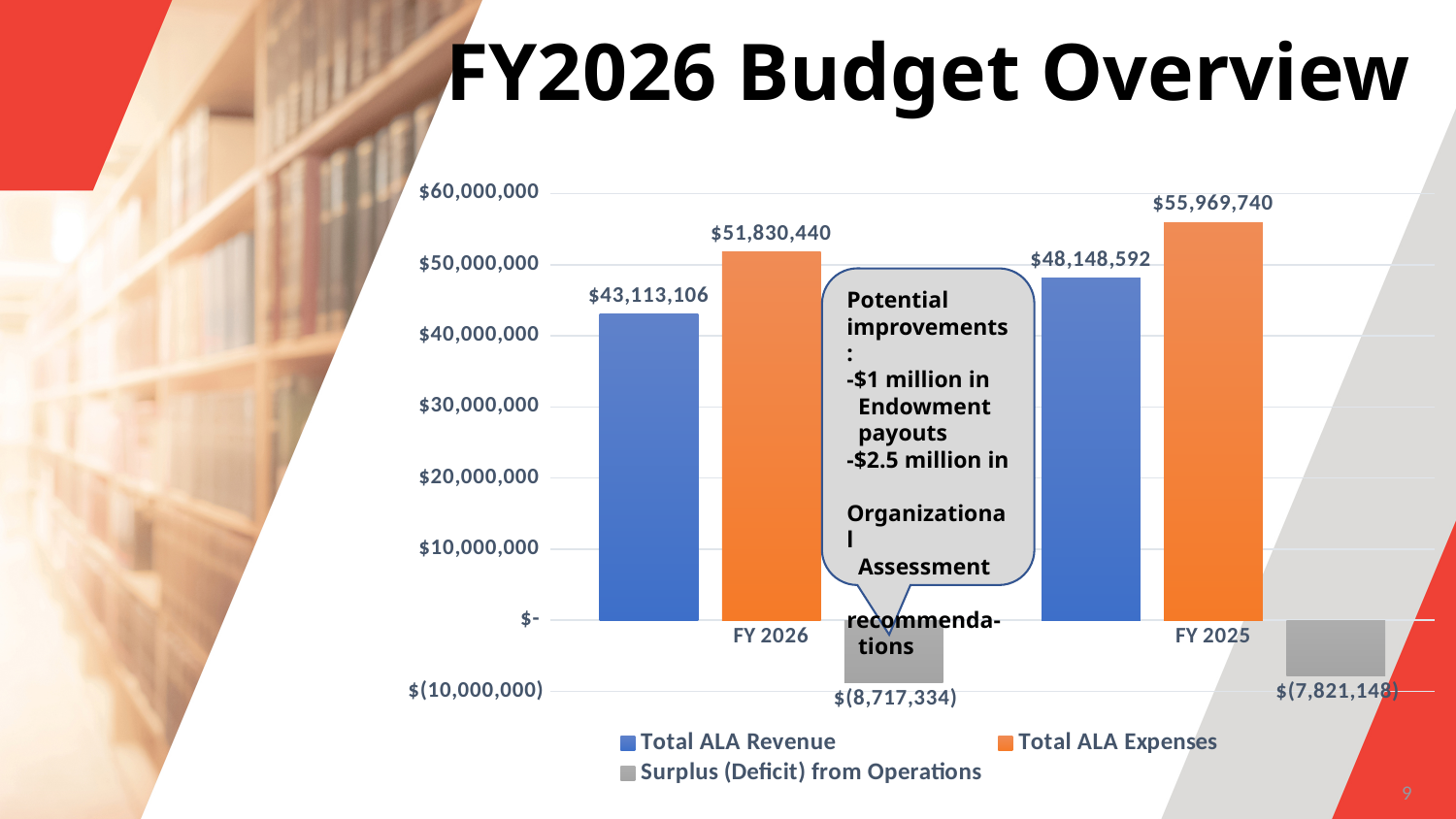
What is the difference between Total ALA Expenses and Total ALA Revenue in FY 2025? $7,821,148 What colour represents Total ALA Expenses in the chart? Orange What kind of chart is shown on the slide? Bar chart What is the Total ALA Expenses value for FY 2025? $55,969,740 What is the Total ALA Revenue for FY 2025? $48,148,592 Is Total ALA Revenue or Total ALA Expenses larger in FY 2026? Total ALA Expenses How many series does the legend list? 3 What is the Surplus (Deficit) from Operations for FY 2026? $(8,717,334) Which fiscal year has the higher Total ALA Expenses? FY 2025 What is the Total ALA Revenue for FY 2026? $43,113,106 Is the Total ALA Expenses value for FY 2026 greater or less than $50,000,000? greater Which fiscal year has the lower Total ALA Revenue? FY 2026